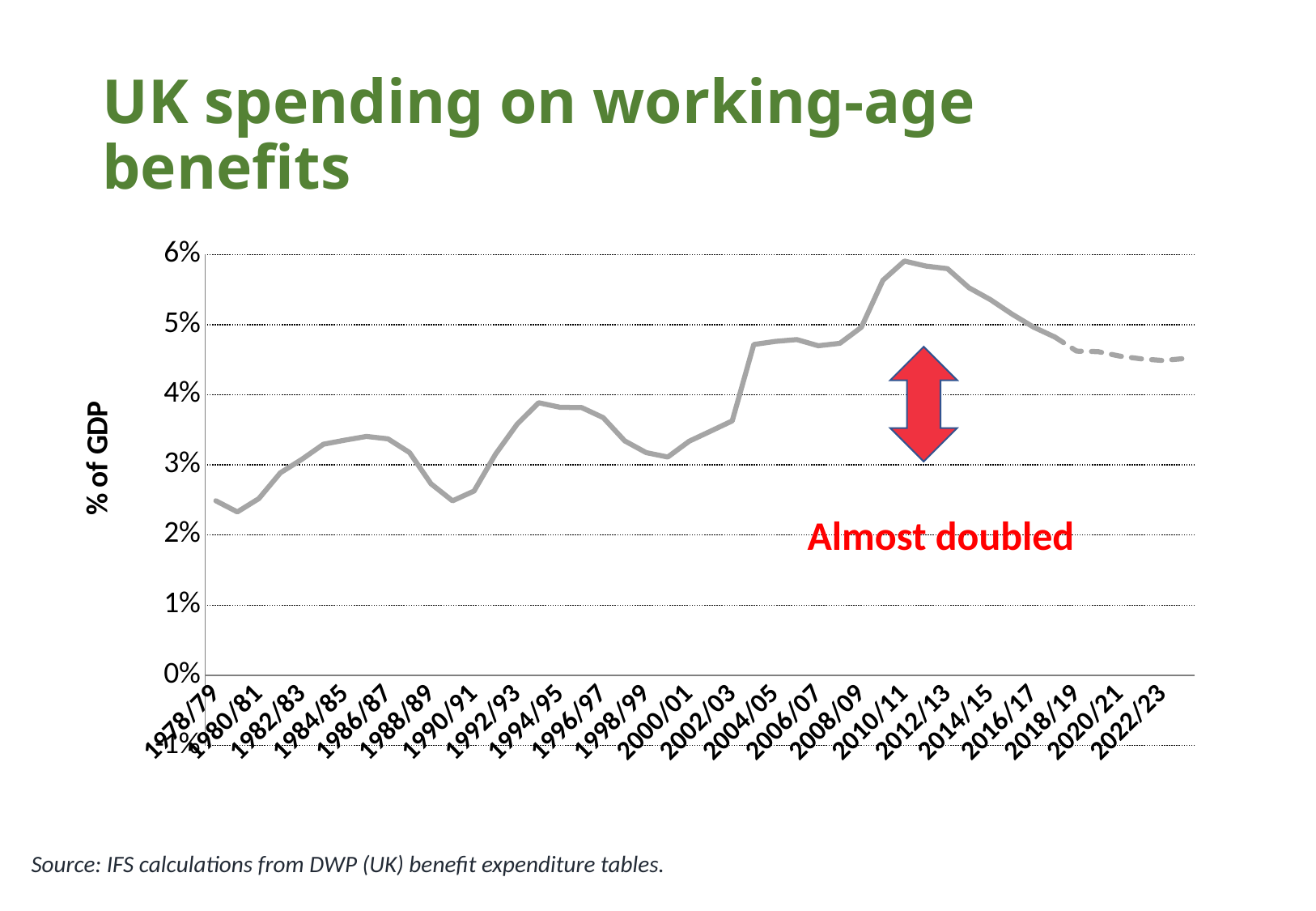
What kind of chart is shown on the slide? line chart Is the value for 2022/23 greater or less than 5%? less Is the value for 2010/11 greater or less than 5%? greater What is the label on the vertical axis of the chart? % of GDP What is the title of the chart? UK spending on working-age benefits Which of the labelled years on the x axis has the highest value? 2010/11 Does the value rise or fall between 2010/11 and 2022/23? fall Is the value for 1978/79 greater or less than 2%? greater Which has the larger value, 2010/11 or 1978/79? 2010/11